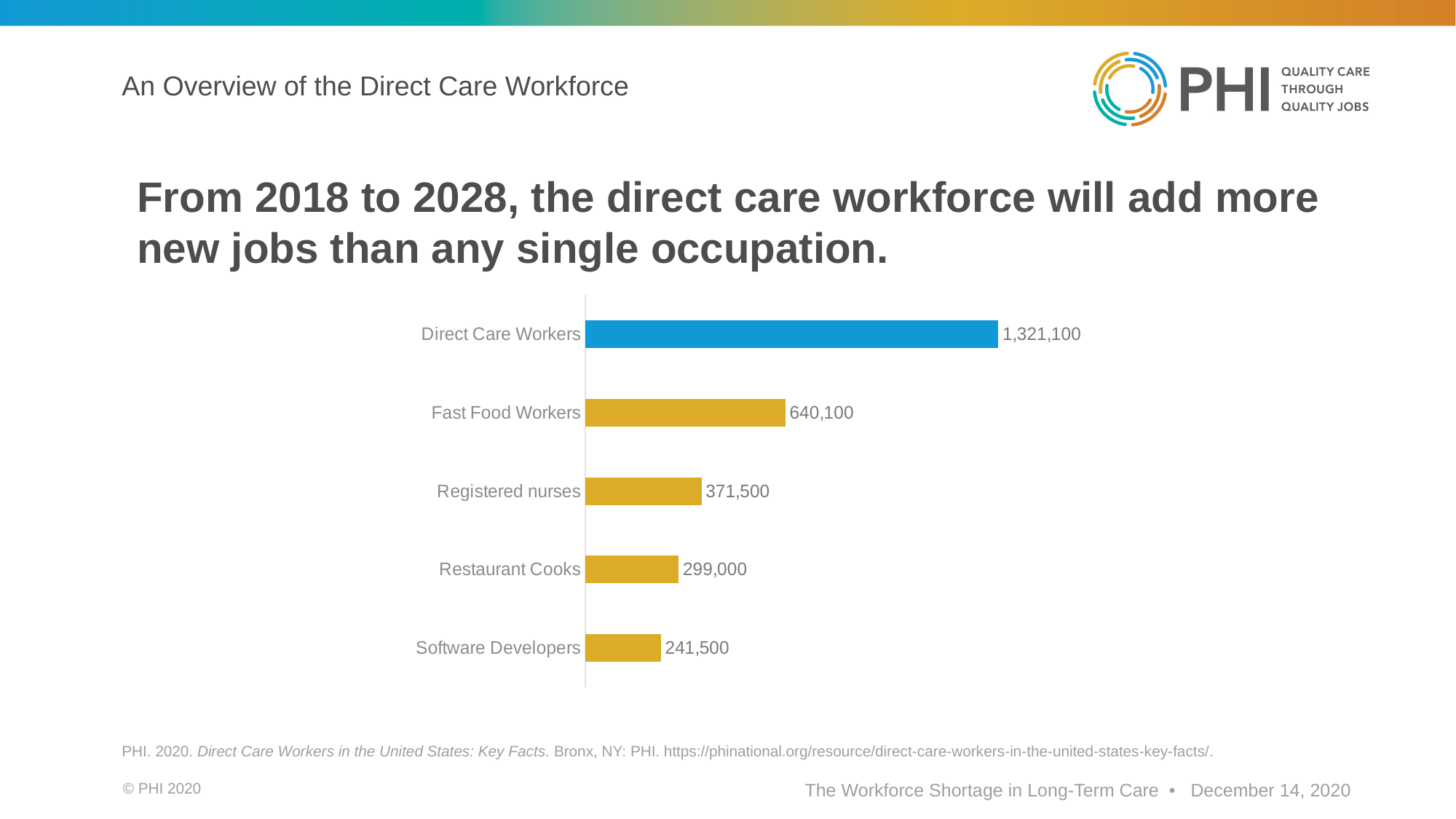
Which occupation has the lowest value in the chart? Software Developers What value is shown for Registered nurses? 371,500 What is the difference between the values for Direct Care Workers and Fast Food Workers? 681,000 What is the difference between the values for Restaurant Cooks and Software Developers? 57,500 What value is shown for Fast Food Workers? 640,100 Which bar in the chart is coloured blue rather than gold? Direct Care Workers Which occupation has the highest value in the chart? Direct Care Workers What kind of chart is shown on the slide? Bar chart How many occupations are shown in the chart? 5 What value is shown for Software Developers? 241,500 What value is shown for Direct Care Workers? 1,321,100 Which is larger, the value for Registered nurses or the value for Restaurant Cooks? Registered nurses